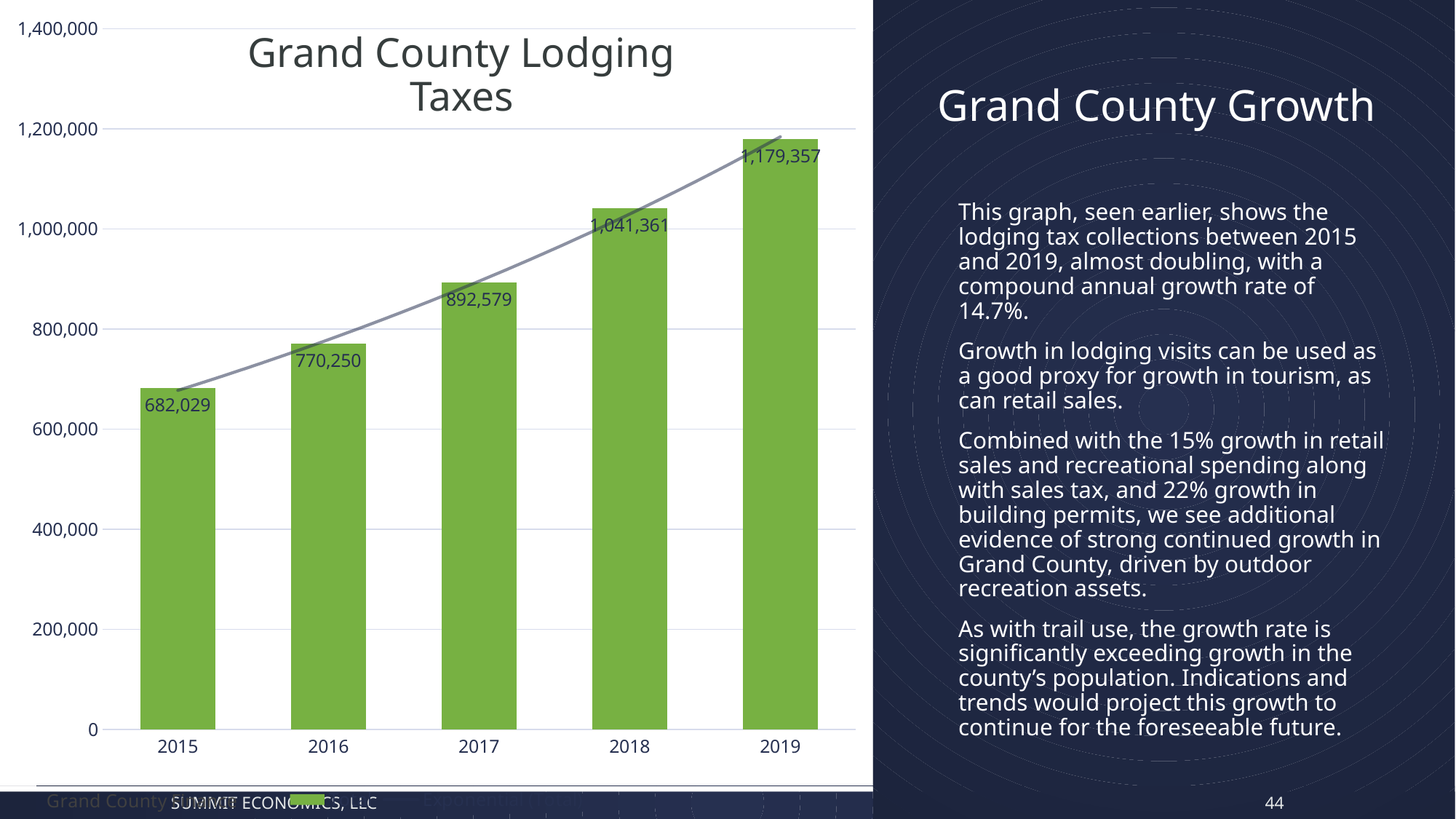
What kind of chart is used to show Grand County Lodging Taxes? bar chart What is the difference between the 2018 and 2017 lodging tax values? 148,782 How many years are shown on the x axis of the chart? 5 What is the lodging tax value for 2018? 1,041,361 What is the lodging tax value for 2015? 682,029 Do the lodging tax values rise or fall from 2015 to 2019? rise Is the value for 2015 greater or less than 800,000? less Which year has the highest lodging tax value? 2019 What is the difference between the 2019 and 2015 lodging tax values? 497,328 What is the lodging tax value for 2017? 892,579 Which year has the lowest lodging tax value? 2015 Which year has a larger lodging tax value, 2016 or 2018? 2018